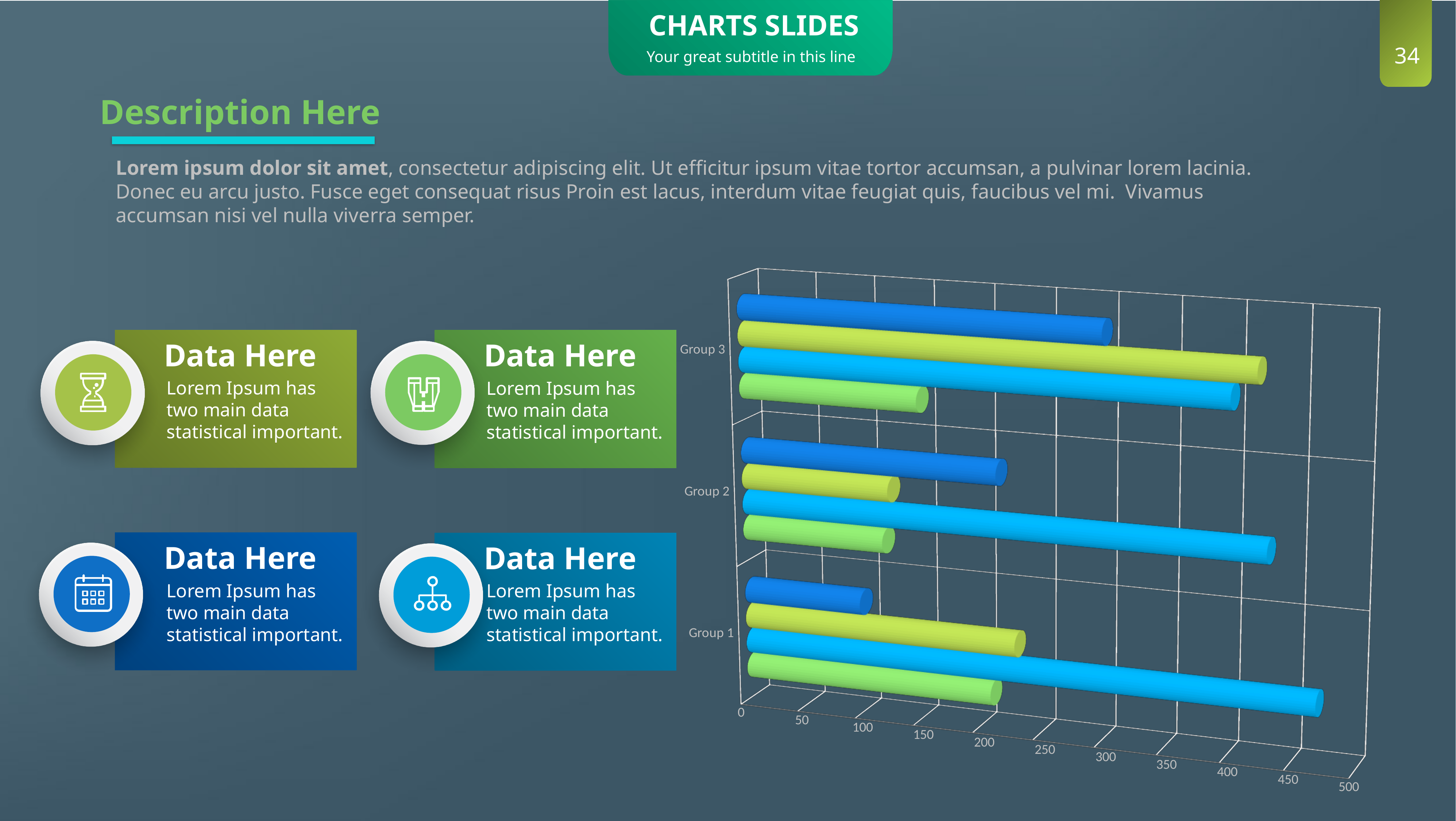
Is the value of the dark blue bar for Group 1 greater or less than 150? less What kind of chart is shown on the slide? bar chart Which group has the longest dark blue bar? Group 3 What is the highest value shown on the chart's horizontal axis? 500 How many bars are plotted for each group in the chart? 4 Which bar is the longest for Group 1? the light blue (cyan) bar For Group 2, which is larger: the dark blue bar or the yellow-green bar? the dark blue bar How many groups (categories) are shown on the chart's vertical axis? 3 Which bar is the shortest for Group 3? the green bar Is the value of the green bar for Group 3 greater or less than 200? less Is the value of the light blue (cyan) bar for Group 1 greater or less than 400? greater